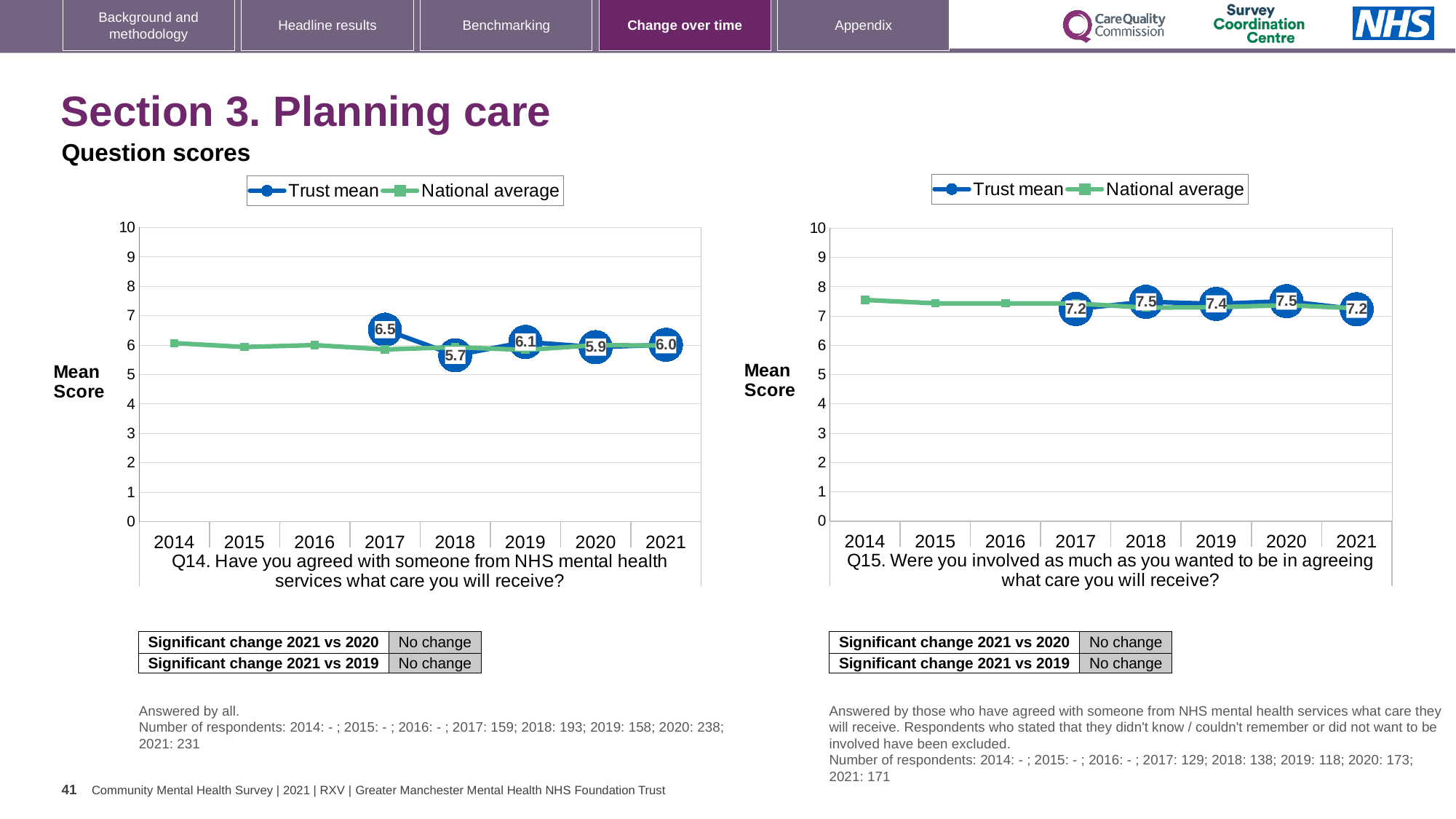
In the Q15 chart on the right, what is the difference between the Trust mean in 2020 and in 2021? 0.3 What kind of chart is the Q14 chart on the left? Line chart In the Q15 chart on the right, which is larger, the Trust mean in 2018 or in 2021? 2018 In the Q14 chart on the left, what is the difference between the Trust mean in 2017 and in 2018? 0.8 In the Q14 chart on the left, which year has the lowest Trust mean? 2018 In the Q14 chart on the left, which year has the highest Trust mean? 2017 In the Q15 chart on the right, is the National average for 2014 greater or less than 7? greater How many years are shown on the x axis of the Q14 chart on the left? 8 In the Q14 chart on the left, what is the Trust mean for 2021? 6.0 How many series does the legend of the Q15 chart on the right list? 2 In the Q14 chart on the left, what is the Trust mean for 2017? 6.5 In the Q15 chart on the right, what is the Trust mean for 2019? 7.4